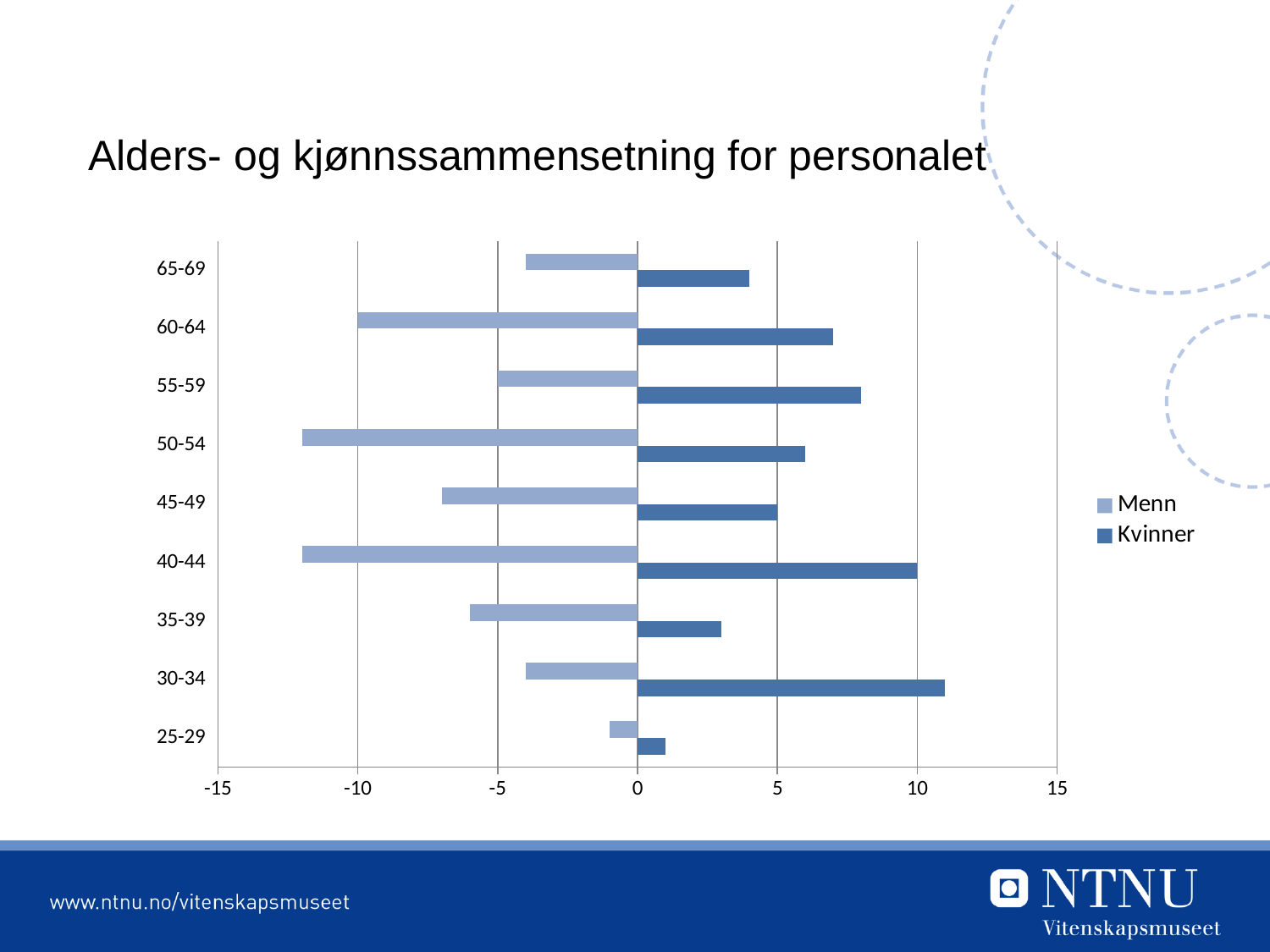
What kind of chart is shown on the slide? bar chart Which Menn bar is longer, 60-64 or 65-69? 60-64 Is the Kvinner value for 35-39 greater or less than 5? less What is the title of the chart? Alders- og kjønnssammensetning for personalet Is the Kvinner value for 30-34 greater or less than 10? greater How many age groups are shown on the vertical axis? 9 Is the Menn value for 50-54 greater or less than -10? less How many series does the legend list? 2 Which age group has the shortest Kvinner bar? 25-29 Which age group has the longest Kvinner bar? 30-34 Which Kvinner bar is longer, 55-59 or 65-69? 55-59 Which age group has the shortest Menn bar? 25-29